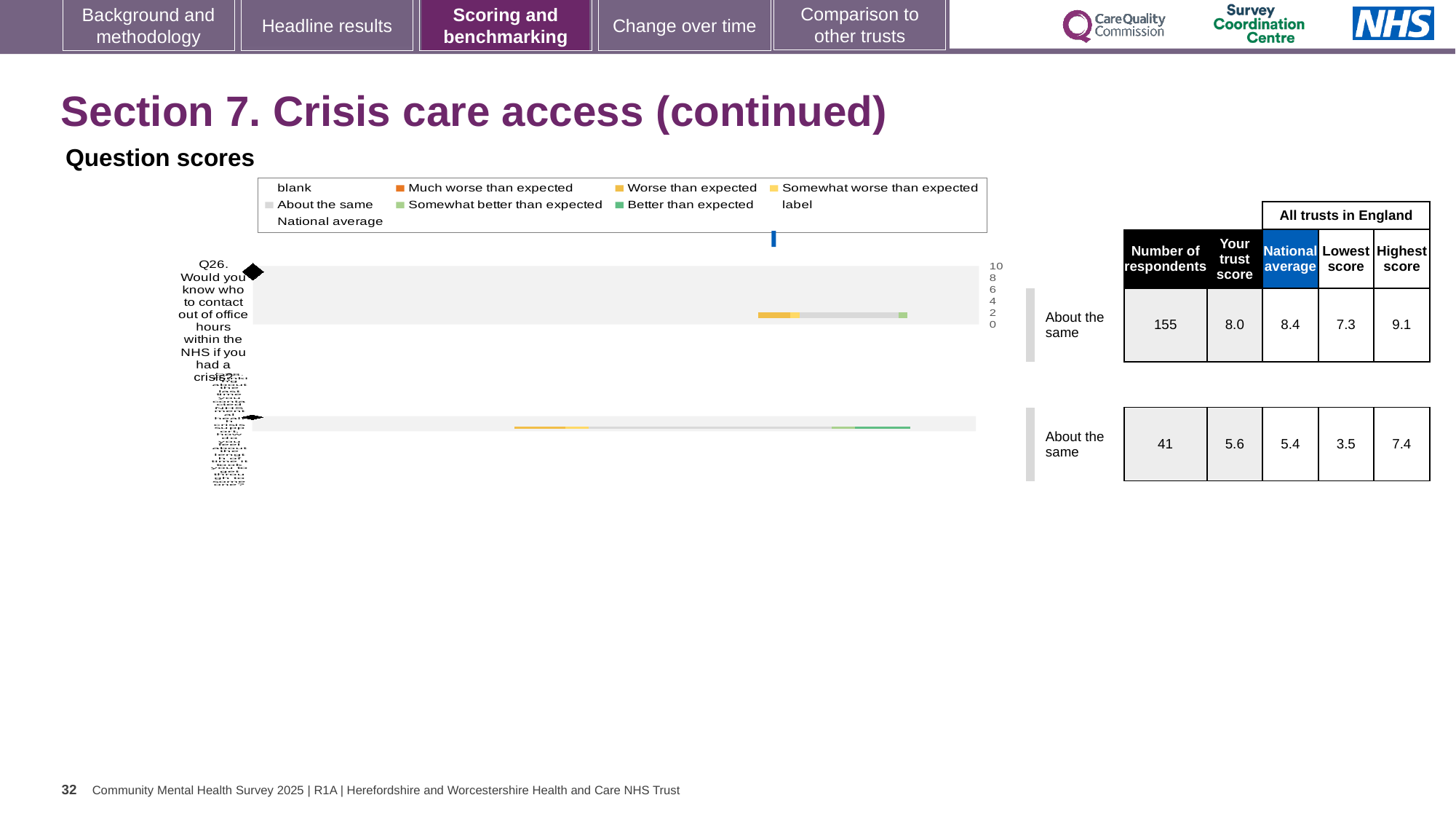
For Q26, what is the difference between the highest score and the lowest score among all trusts in England? 1.8 What kind of chart is used to show the question scores on this slide? bar chart How many respondents answered Q26? 155 For Q26, which is larger: the trust score or the national average? national average What is the trust score for Q26 (Would you know who to contact out of office hours within the NHS if you had a crisis?)? 8.0 In the chart legend, what colour represents 'Much worse than expected'? orange What is the highest score among all trusts in England for Q26? 9.1 In the chart legend, what colour represents 'Better than expected'? green How many question bars are plotted in the question scores chart? 2 What benchmark category is shown for Q26? About the same What is the lowest score among all trusts in England for Q26? 7.3 What is the national average score for Q26? 8.4